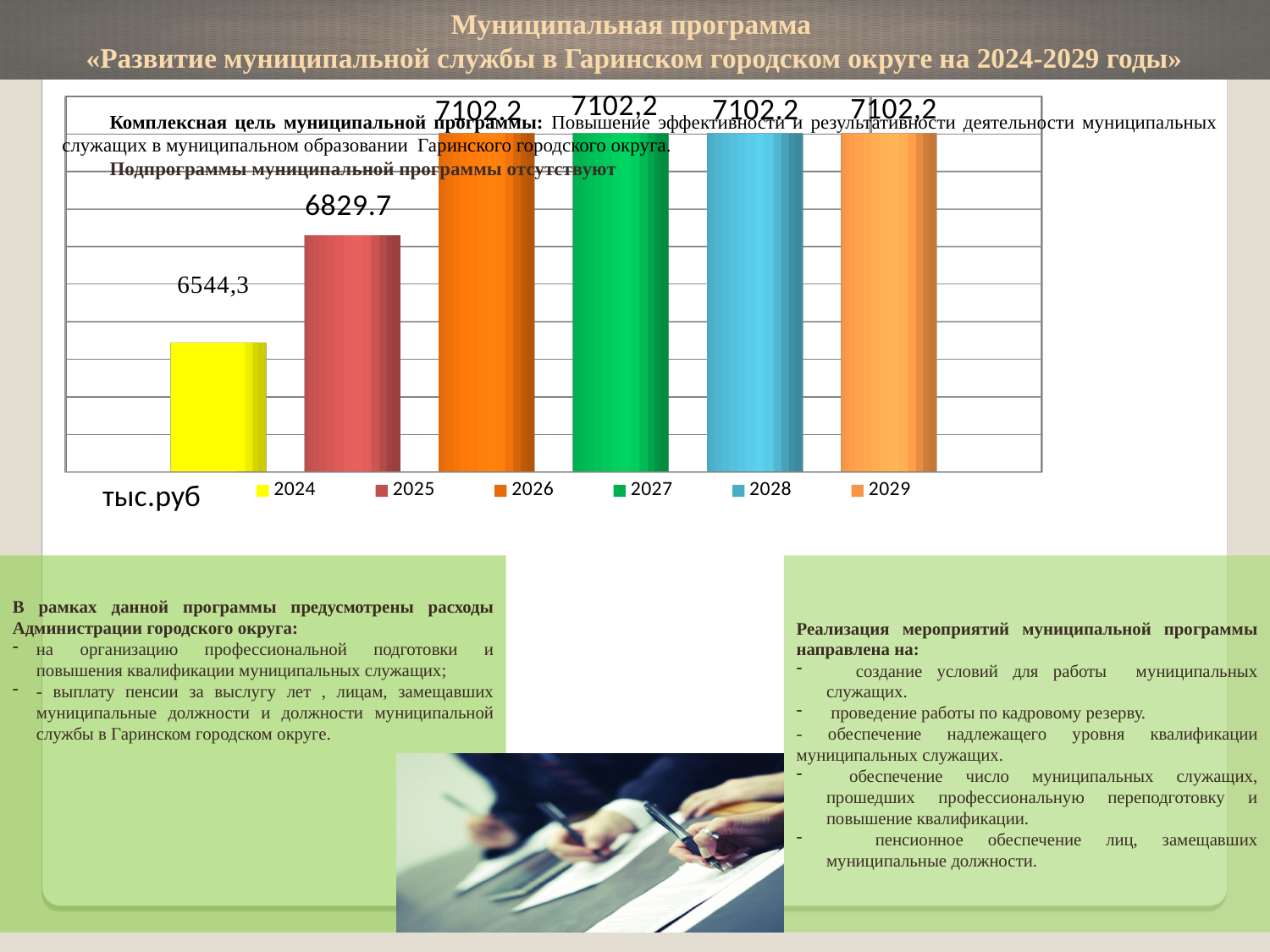
What is the value for 2025? 6829.7 Which is larger, the value for 2024 or the value for 2025? 2025 How many entries does the legend list? 6 What is the highest value shown on the chart? 7102,2 What unit label is shown at the bottom left of the chart? тыс.руб What is the value for 2024? 6544,3 What is the difference between the values for 2025 and 2024? 285,4 What is the difference between the values for 2026 and 2025? 272,5 What is the value for 2027? 7102,2 What kind of chart is shown on the slide? bar chart Which year has the lowest value? 2024 How many bars are plotted on the chart? 6